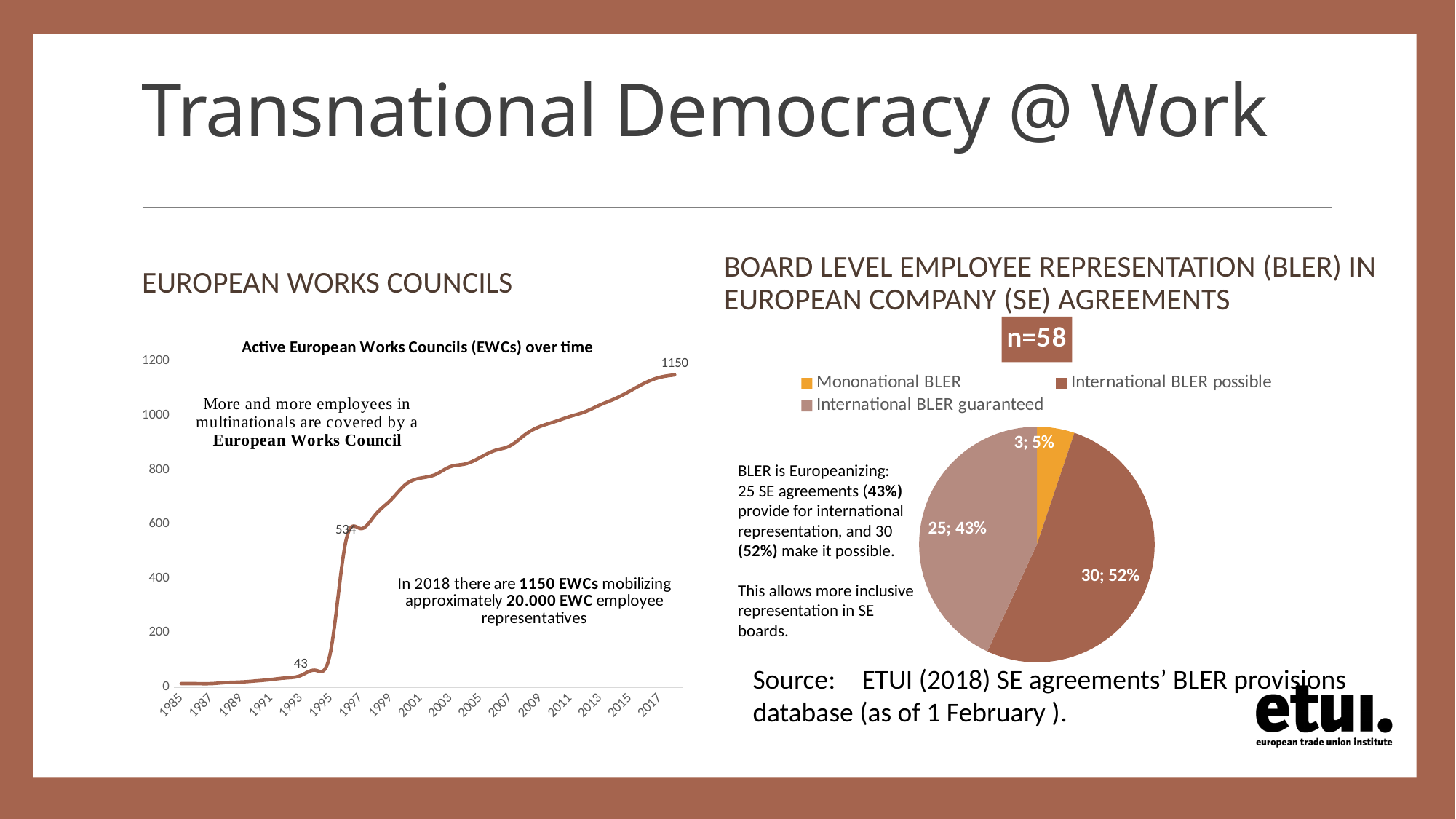
On the 'Active European Works Councils (EWCs) over time' chart, do the values generally rise or fall from 1985 to 2017? rise On the 'Active European Works Councils (EWCs) over time' chart, is the value for 2009 greater or less than 800? greater On the BLER pie chart, which category has the smallest slice? Mononational BLER On the BLER pie chart, what is the value shown for International BLER possible? 30; 52% On the 'Active European Works Councils (EWCs) over time' chart, what is the value of the last data label shown at the end of the line? 1150 On the BLER pie chart, how many categories does the legend list? 3 On the 'Active European Works Councils (EWCs) over time' chart, what is the value of the data label shown near 1993? 43 On the 'Active European Works Councils (EWCs) over time' chart, what kind of chart is used? line chart On the BLER pie chart, which category has the largest slice? International BLER possible On the 'Active European Works Councils (EWCs) over time' chart, what is the value of the data label shown near 1996? 534 On the 'Active European Works Councils (EWCs) over time' chart, what is the difference between the labelled values 1150 and 534? 616 On the BLER pie chart, what is the value shown for Mononational BLER? 3; 5%